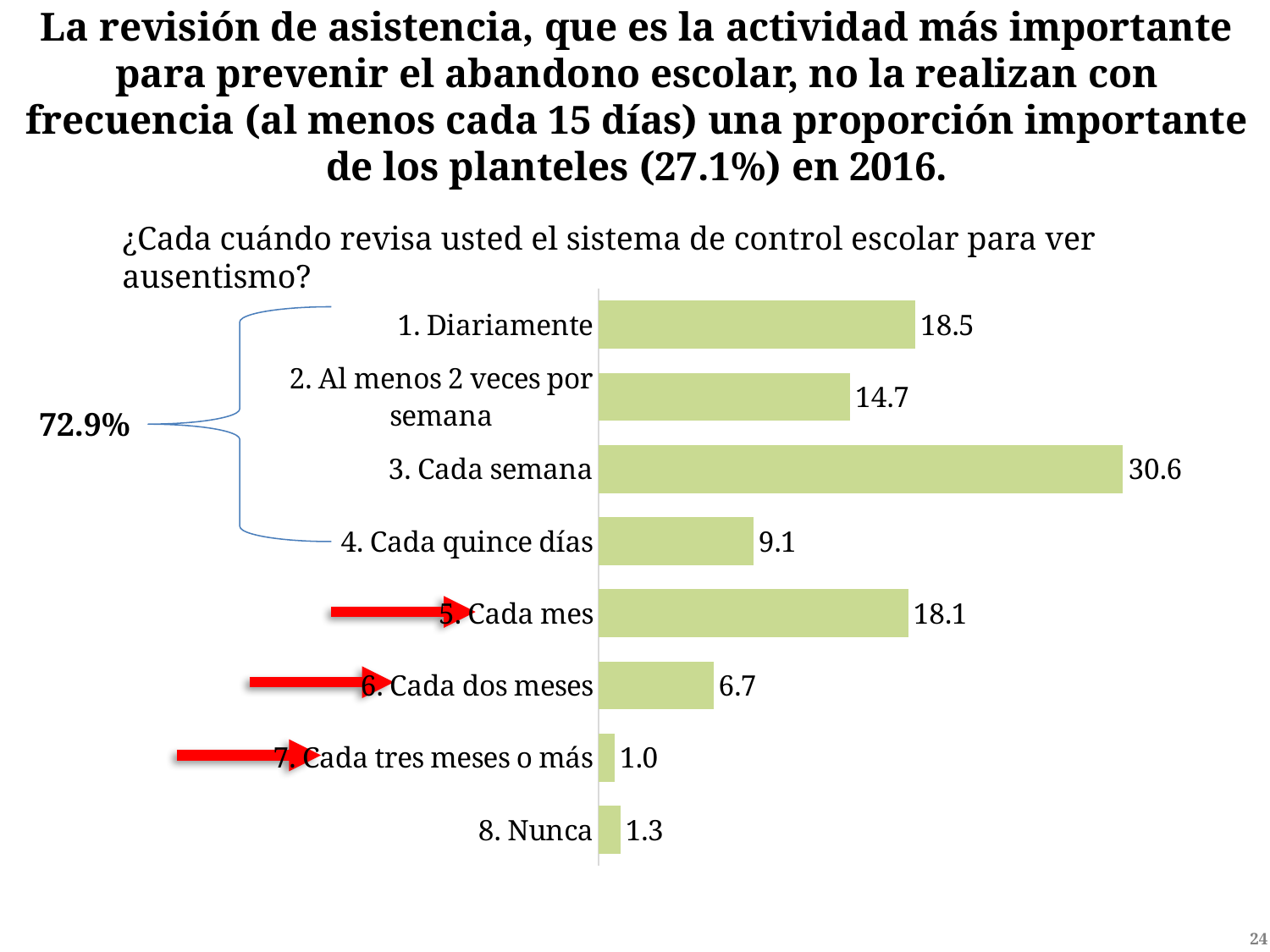
What is the difference between the values for "3. Cada semana" and "4. Cada quince días"? 21.5 What is the value for "3. Cada semana"? 30.6 Which category has the highest value? 3. Cada semana What is the value for "1. Diariamente"? 18.5 What kind of chart is shown on the slide? Bar chart Which is larger, the value for "1. Diariamente" or the value for "5. Cada mes"? 1. Diariamente Which category has the lowest value? 7. Cada tres meses o más What is the difference between the values for "5. Cada mes" and "6. Cada dos meses"? 11.4 What percentage is shown next to the bracket grouping the first four categories? 72.9% What is the value for "7. Cada tres meses o más"? 1.0 What is the value for "8. Nunca"? 1.3 How many categories does the chart show? 8